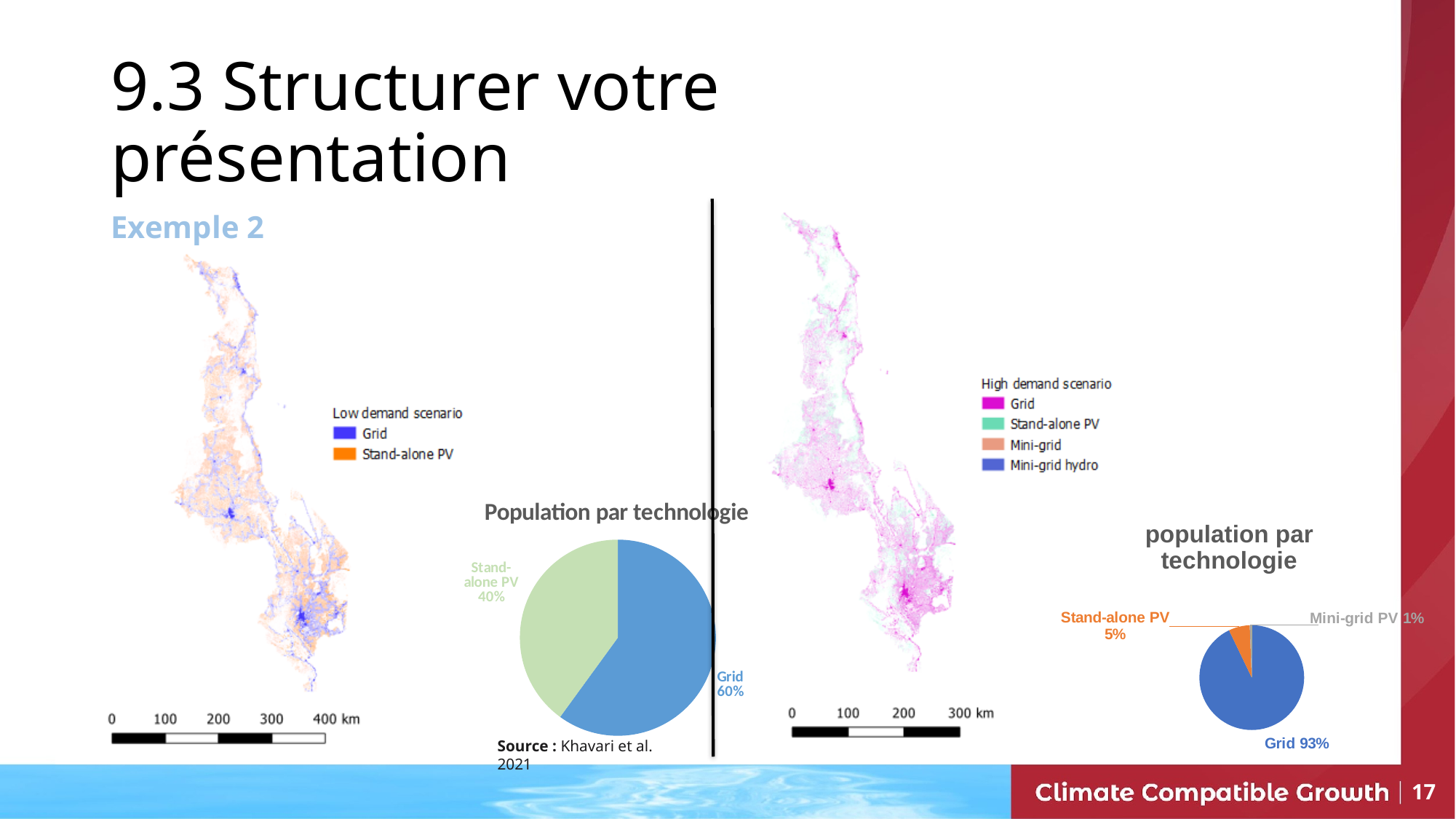
In the left pie chart titled 'Population par technologie', which category has the largest share? Grid In the left pie chart titled 'Population par technologie', what share does Stand-alone PV have? 40% In the right pie chart titled 'population par technologie', what share does Grid have? 93% What type of chart is the left chart titled 'Population par technologie'? Pie chart In the right pie chart titled 'population par technologie', what share does Mini-grid PV have? 1% In the right pie chart titled 'population par technologie', what share does Stand-alone PV have? 5% How many slices does the left pie chart titled 'Population par technologie' have? 2 In the right pie chart titled 'population par technologie', which is larger: Stand-alone PV or Mini-grid PV? Stand-alone PV In the left pie chart titled 'Population par technologie', what is the difference in percentage points between Grid and Stand-alone PV? 20 percentage points In the left pie chart titled 'Population par technologie', what share does Grid have? 60%